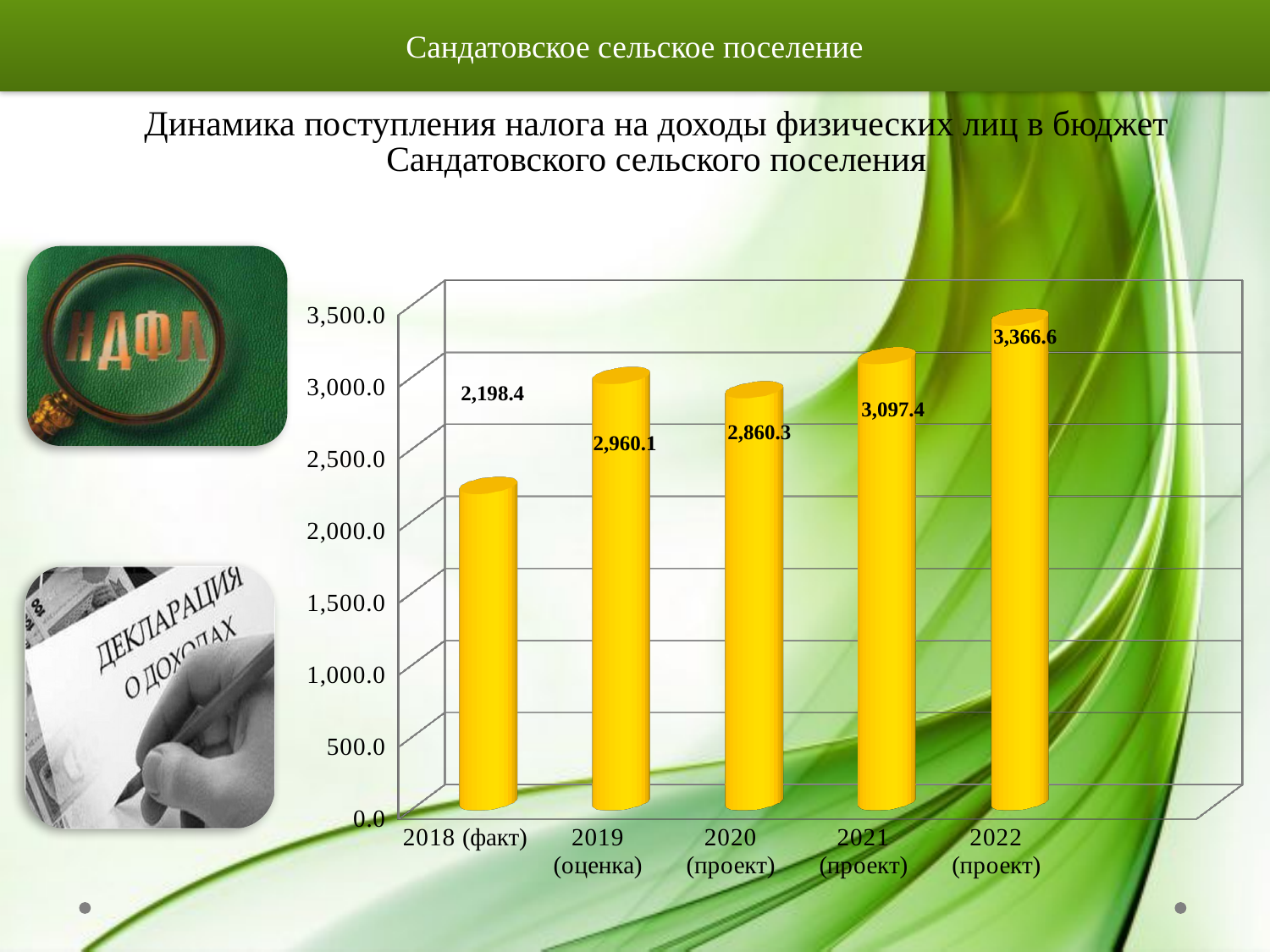
What is the value for 2018 (факт)? 2,198.4 What is the value for 2022 (проект)? 3,366.6 Which is larger, the value for 2019 (оценка) or the value for 2020 (проект)? 2019 (оценка) What kind of chart is shown on the slide? bar chart What is the difference between the values for 2019 (оценка) and 2020 (проект)? 99.8 Does the value rise or fall from 2019 (оценка) to 2020 (проект)? fall Is the value for 2021 (проект) greater or less than 3,000.0? greater Which category has the lowest value? 2018 (факт) Which category has the highest value? 2022 (проект) What is the difference between the values for 2022 (проект) and 2018 (факт)? 1,168.2 What is the value for 2020 (проект)? 2,860.3 How many categories are shown on the x axis? 5